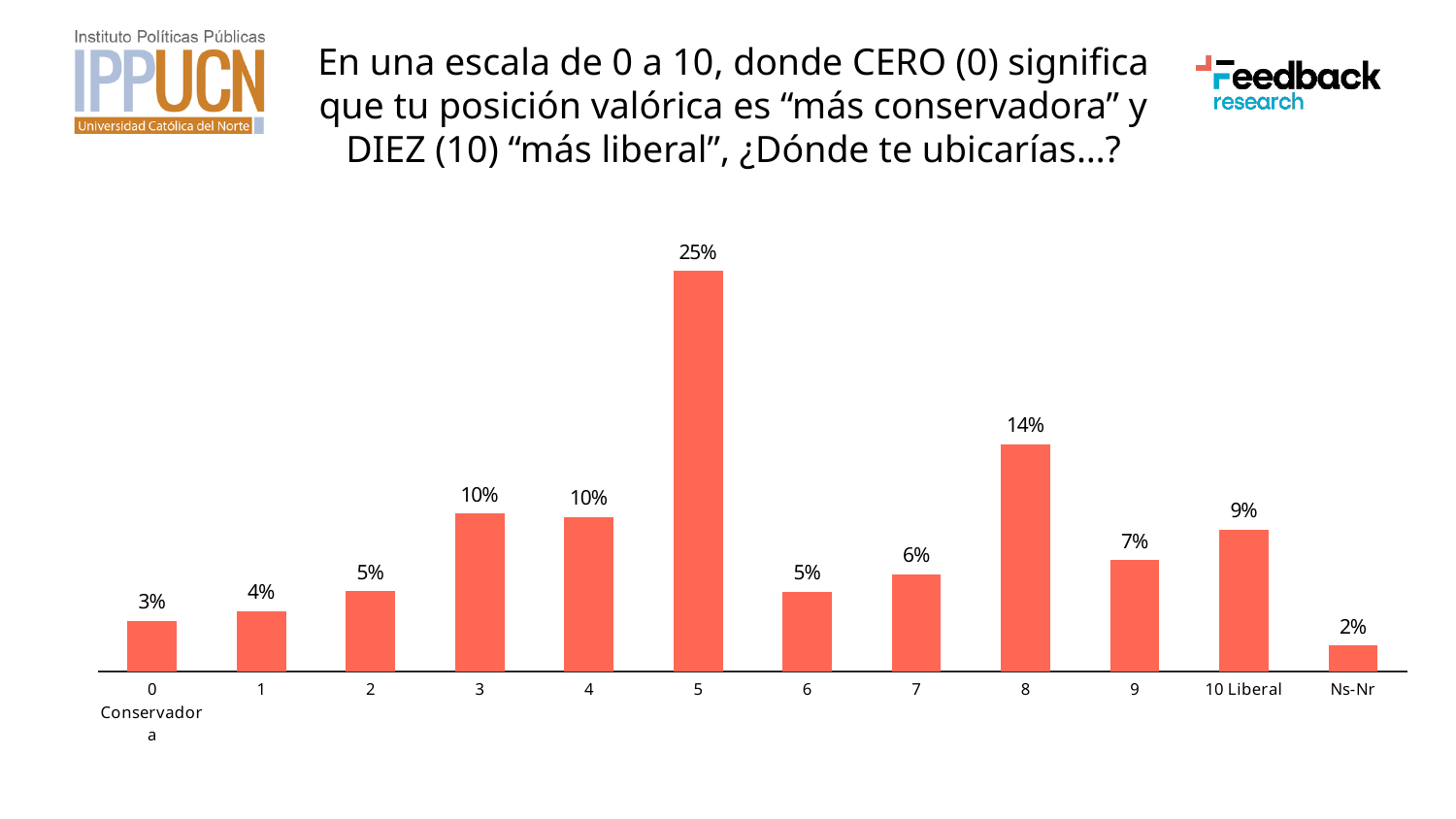
What percentage is shown for the 'Ns-Nr' category? 2% How many categories are shown on the x axis? 12 What percentage of respondents placed themselves at 5 on the scale? 25% What is the difference between the values for category 5 and category 8? 11% What is the value shown for the '10 Liberal' category? 9% What colour are the bars in the chart? Orange-red What kind of chart is shown on the slide? Bar chart Which has a larger value, category 7 or category 9? 9 Which category has the lowest value? Ns-Nr Which category has the highest value? 5 Do the values rise or fall from category 5 to category 7? Fall What is the value for category 8? 14%